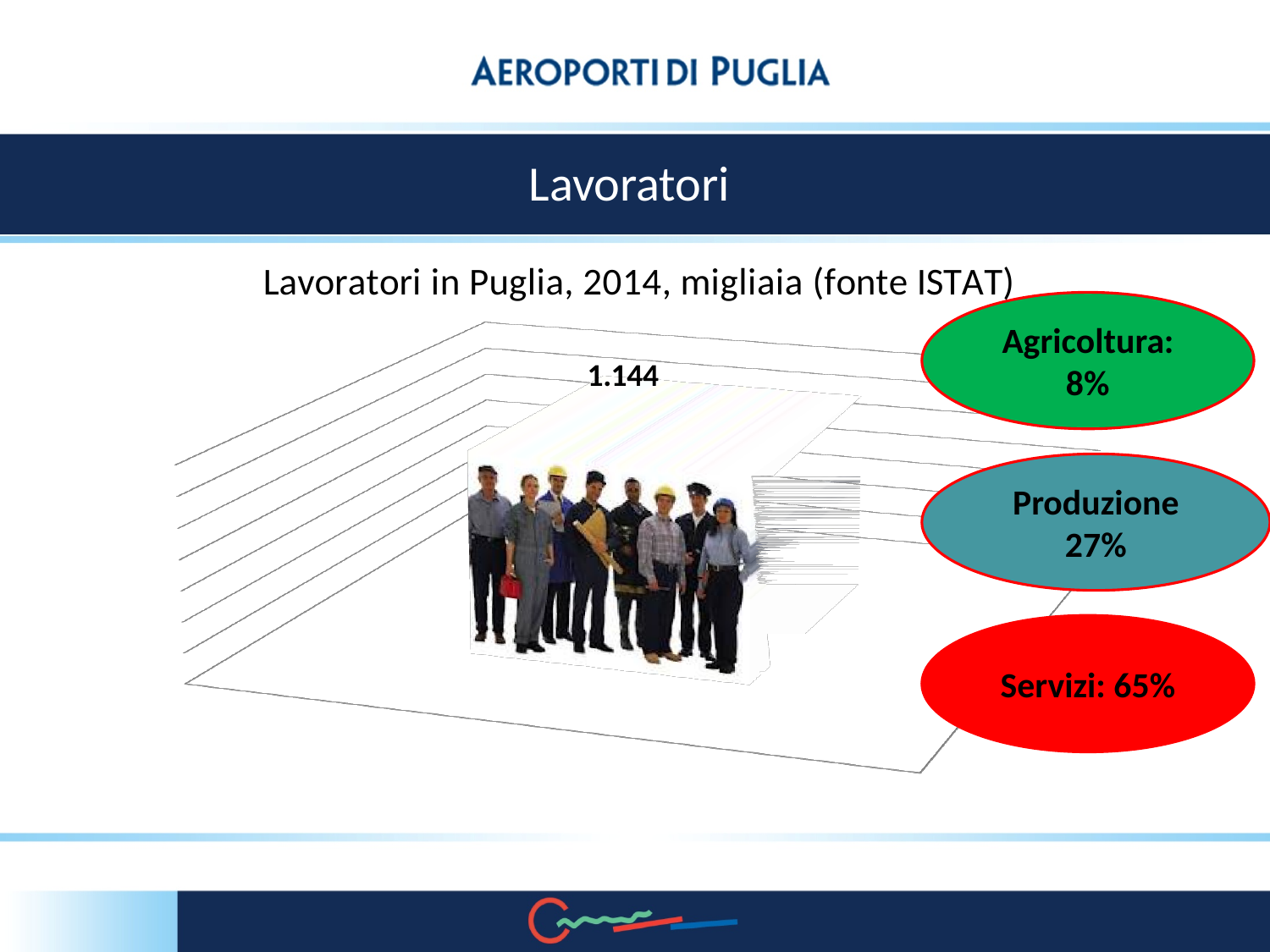
What percentage is shown for Servizi in the oval next to the chart? 65% What is the title of the chart? Lavoratori in Puglia, 2014, migliaia (fonte ISTAT) Which sector shown in the ovals has the highest percentage? Servizi What kind of chart is shown on the slide? bar chart Which is larger, the Produzione percentage or the Agricoltura percentage? Produzione What percentage is shown for Agricoltura in the oval next to the chart? 8% How many bars does the chart contain? 1 What is the difference between the Servizi and Produzione percentages shown in the ovals? 38% According to the chart title, in what unit are the workers counted? migliaia Which sector shown in the ovals has the lowest percentage? Agricoltura What value is printed on the bar in the chart? 1.144 What percentage is shown for Produzione in the oval next to the chart? 27%